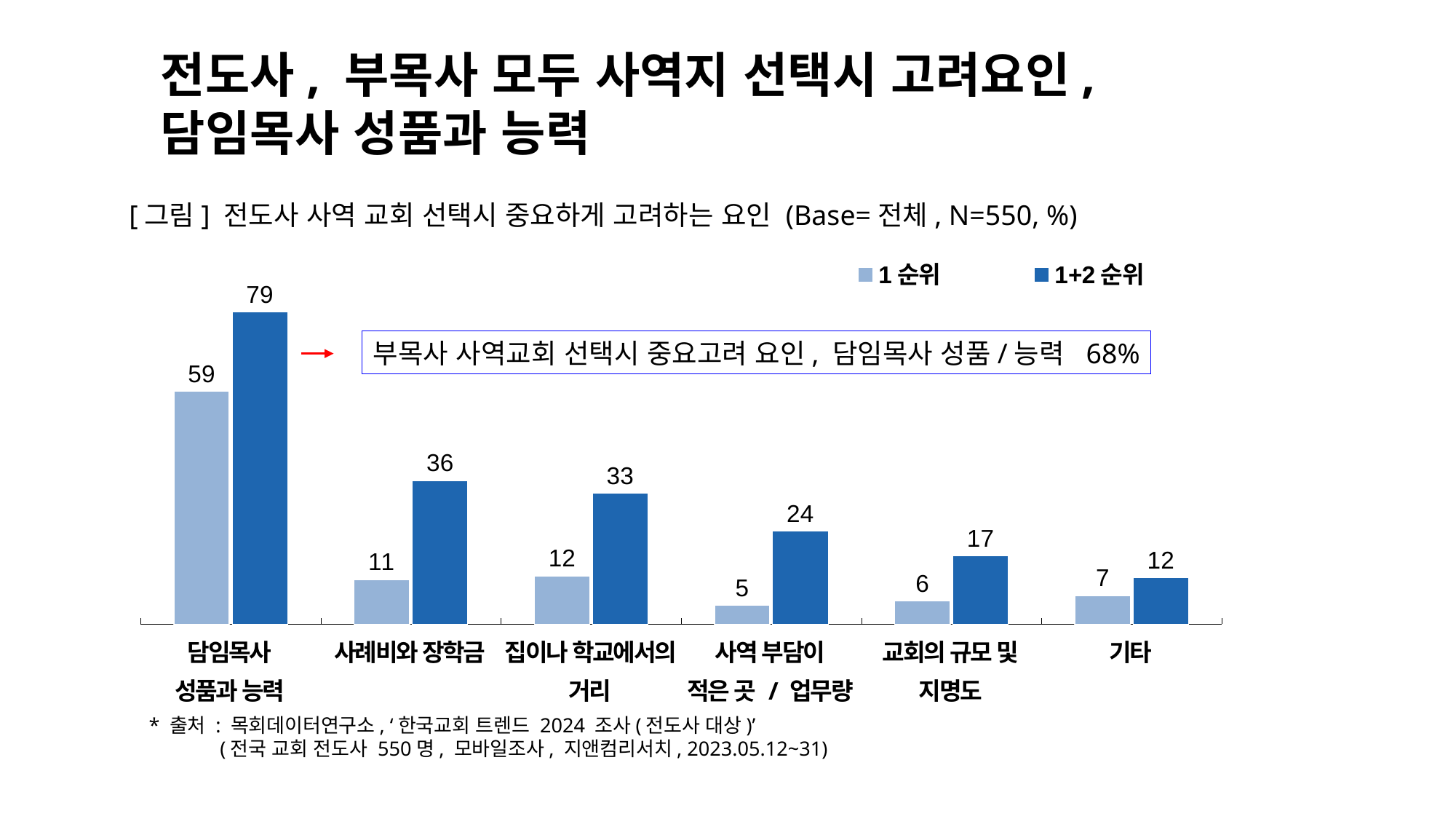
What is the 1+2 순위 value for 집이나 학교에서의 거리? 33 Which category has the highest 1+2 순위 value? 담임목사 성품과 능력 What is the difference between the 1+2 순위 and 1 순위 values for 담임목사 성품과 능력? 20 What is the 1+2 순위 value for 담임목사 성품과 능력? 79 Which is larger, the 1+2 순위 value for 사례비와 장학금 or for 교회의 규모 및 지명도? 사례비와 장학금 How many categories are shown on the x axis? 6 How many series does the legend list? 2 Which category has the lowest 1 순위 value? 사역 부담이 적은 곳 / 업무량 What is the 1 순위 value for 사역 부담이 적은 곳 / 업무량? 5 What kind of chart is shown on the slide? bar chart What is the 1 순위 value for 사례비와 장학금? 11 What percentage is given in the callout box for 부목사 regarding 담임목사 성품/능력? 68%